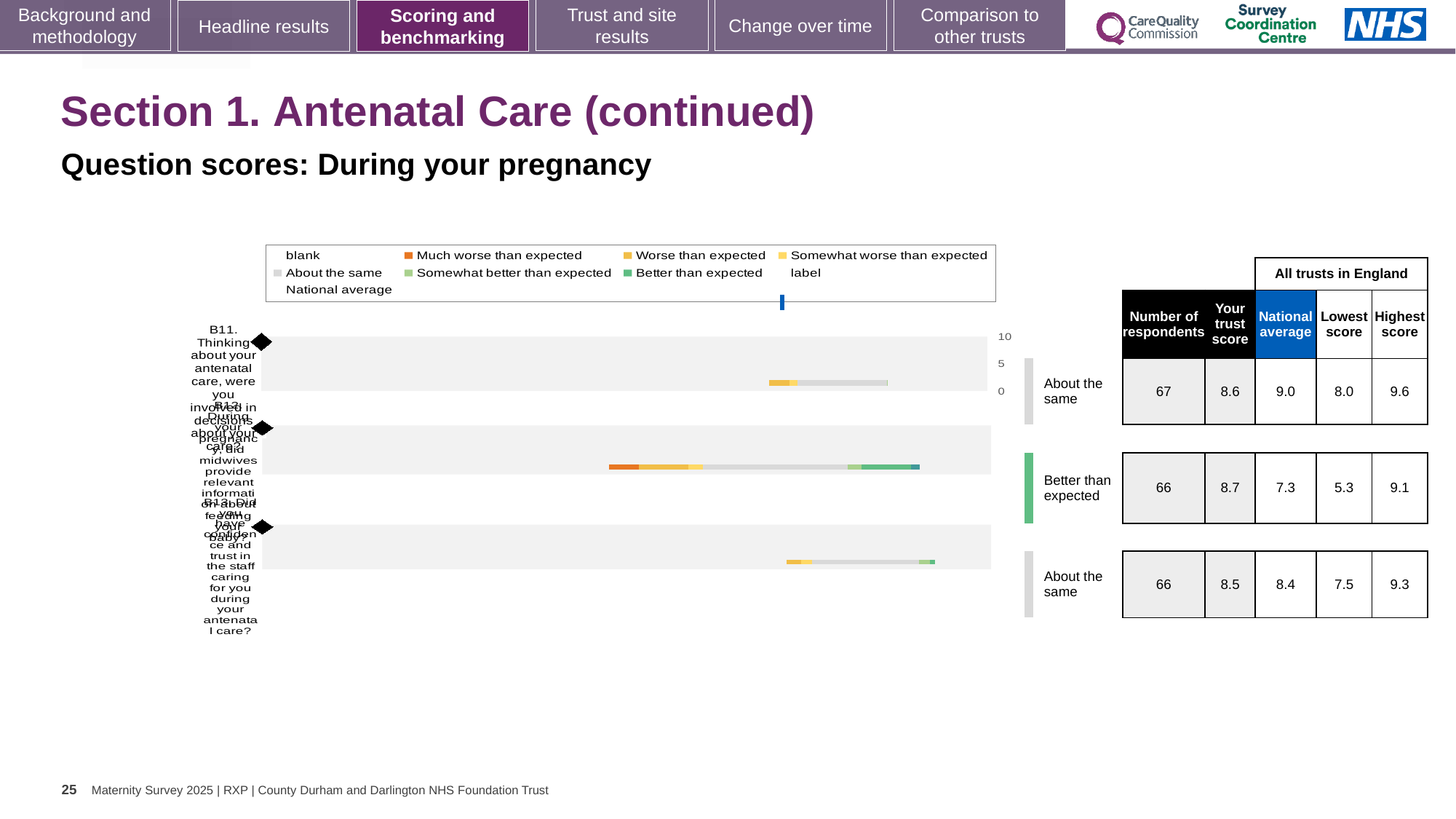
What is the national average for the second question, B12 (midwives provide relevant information about feeding your baby)? 7.3 How many respondents are listed for the third question, B13 (confidence and trust in the staff)? 66 For question B11, what is the difference between the highest score and the lowest score among all trusts in England? 1.6 What is the 'Your trust score' for the first question, B11 (involved in decisions about your care)? 8.6 What benchmark category is shown for question B12? Better than expected Which question has the lowest 'Lowest score' among all trusts in England? B12 For question B11, which is larger: the trust score or the national average? national average What kind of chart is shown on the slide? bar chart What is the highest score among all trusts in England for question B13? 9.3 Which question has the highest 'Your trust score'? B12 How many questions (rows) are plotted in the chart? 3 What is the maximum value shown on the chart's score axis? 10